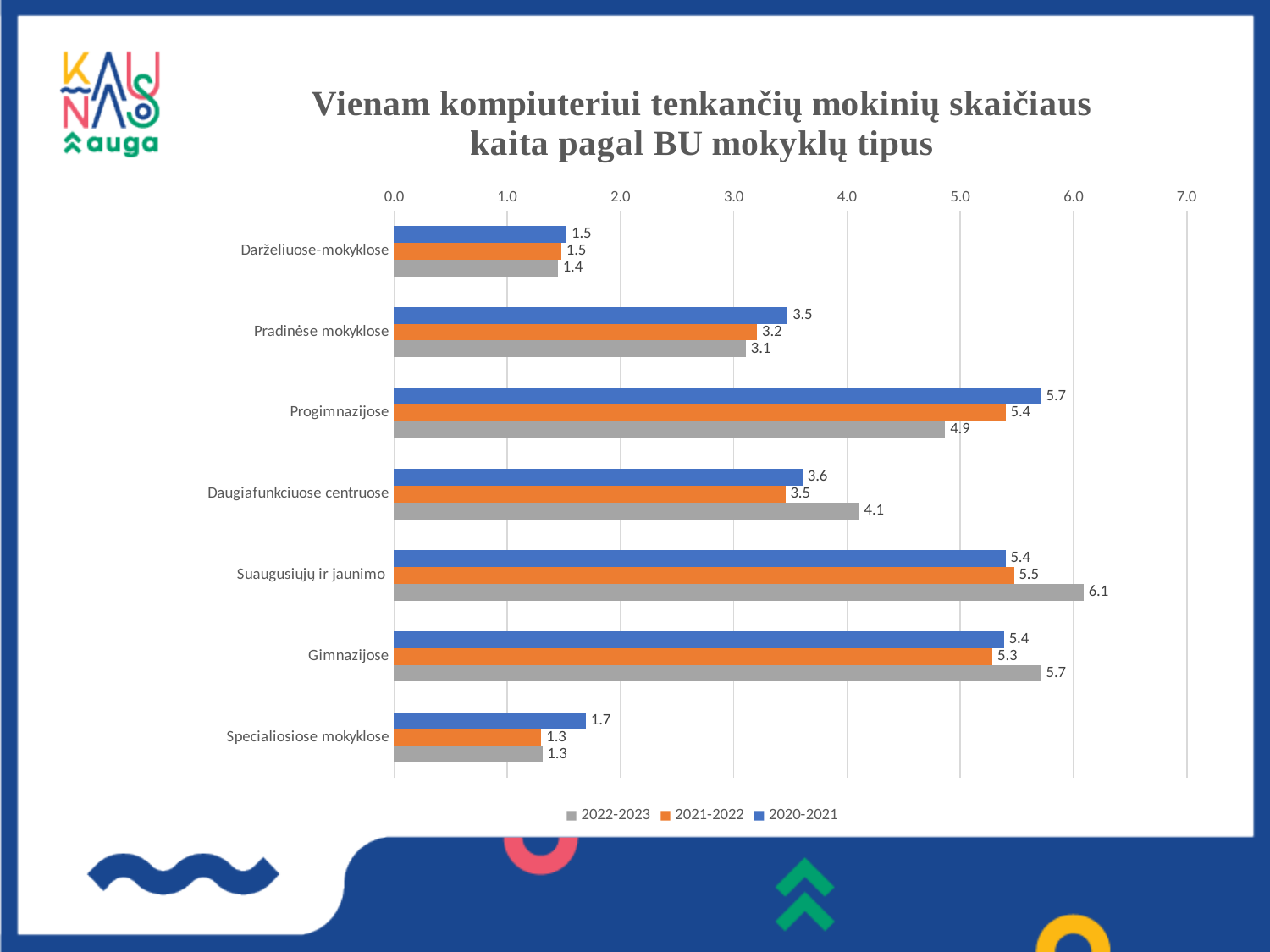
What kind of chart is shown on the slide? Bar chart Which category has the highest 2022-2023 value? Suaugusiųjų ir jaunimo What is the difference between the 2022-2023 and 2020-2021 values for Progimnazijose? 0.8 Is the 2020-2021 value for Pradinėse mokyklose greater or less than 3.0? greater What is the 2022-2023 value for Suaugusiųjų ir jaunimo? 6.1 What is the 2020-2021 value for Progimnazijose? 5.7 Which category has the lowest 2020-2021 value? Darželiuose-mokyklose Which is larger for Gimnazijose: the 2022-2023 value or the 2021-2022 value? 2022-2023 How many series does the legend list? 3 What is the 2021-2022 value for Daugiafunkciuose centruose? 3.5 Which colour represents the 2021-2022 series in the legend? Orange How many school-type categories are shown on the chart? 7